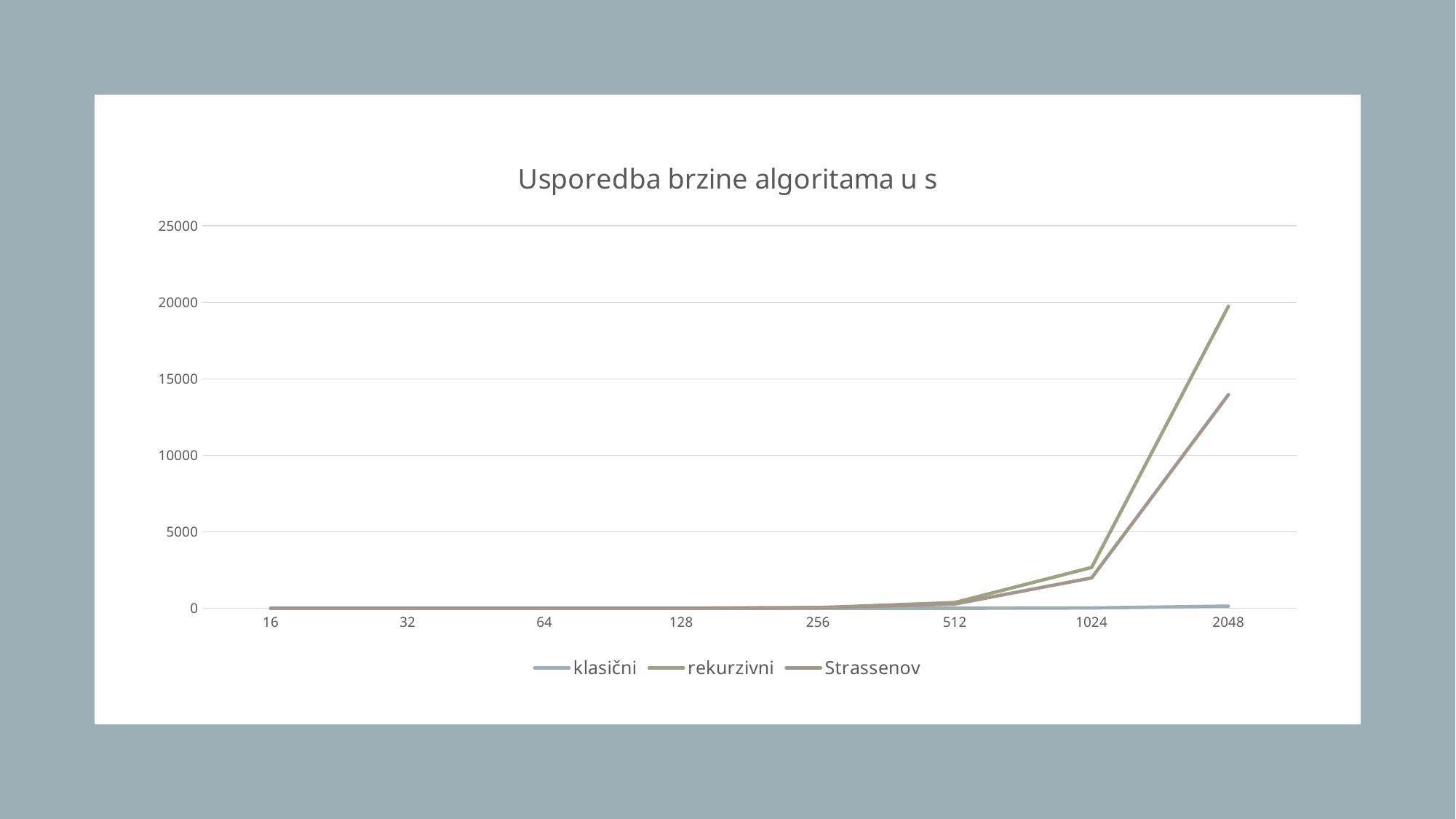
What kind of chart is shown on the slide? line chart Is the value for Strassenov at 2048 greater or less than 15000? less Which is larger at 2048, rekurzivni or Strassenov? rekurzivni How many series does the legend list? 3 Which series has the highest value at 2048? rekurzivni Which series is listed first in the legend? klasični Is the value for rekurzivni at 2048 greater or less than 15000? greater Do the values for rekurzivni rise or fall along the x axis? rise Is the value for rekurzivni at 1024 greater or less than 5000? less How many points are on the x axis? 8 What is the title of the chart? Usporedba brzine algoritama u s Which series has the lowest value at 2048? klasični